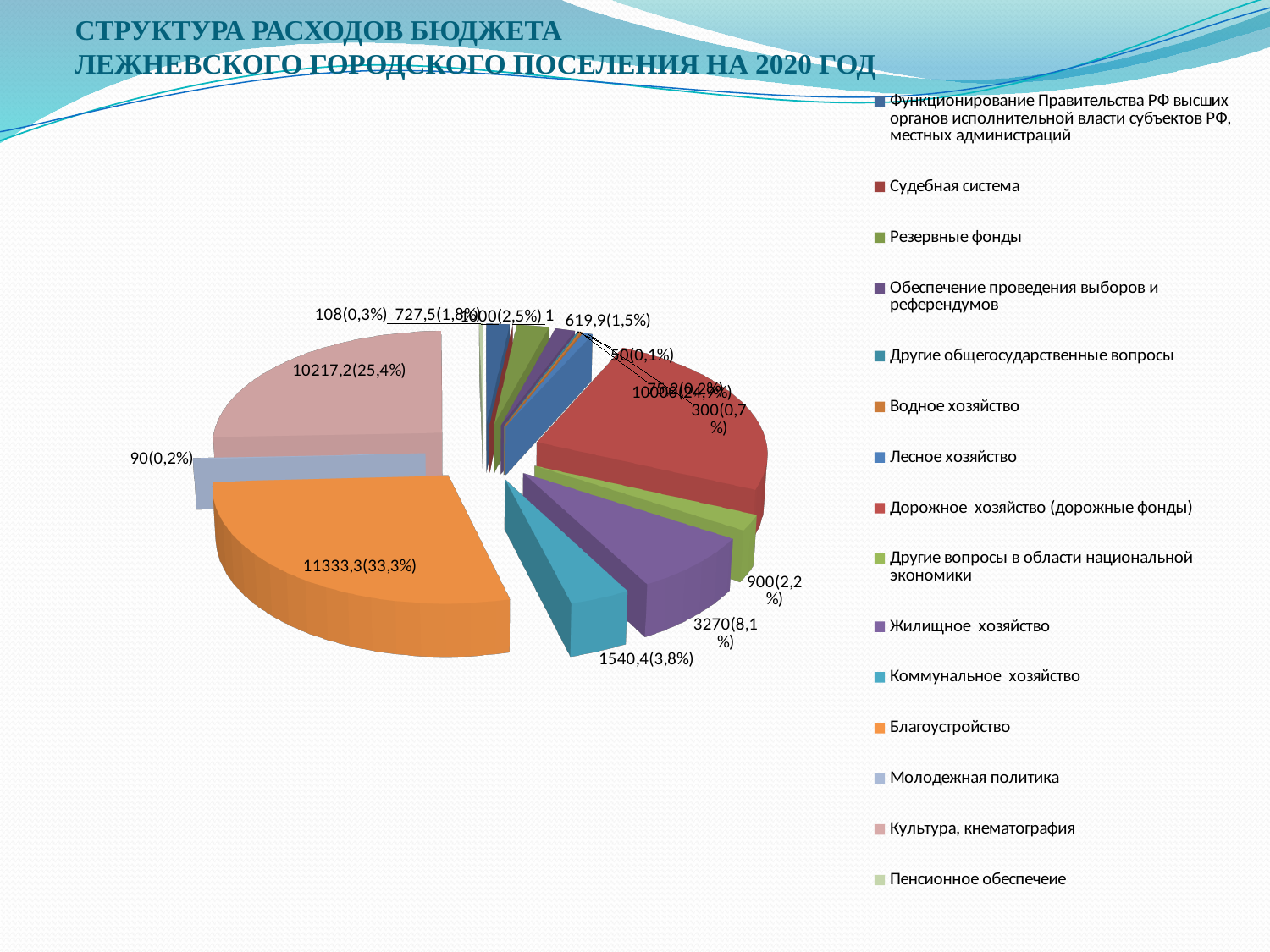
What value is labelled on the slice for Культура, кнематография? 10217,2(25,4%) What is the difference between the values for Благоустройство and Культура, кнематография? 1116,1 What value is labelled on the slice for Коммунальное хозяйство? 1540,4(3,8%) Which category has the largest slice of the pie? Благоустройство What colour is the slice for Благоустройство? orange Which has the larger share: Культура, кнематография or Дорожное хозяйство (дорожные фонды)? Культура, кнематография How many categories does the legend of the pie chart list? 15 What kind of chart is shown on the slide? pie chart What value is labelled on the slice for Жилищное хозяйство? 3270(8,1%) What share of the pie does Благоустройство take? 33,3% What value is labelled on the slice for Благоустройство? 11333,3(33,3%) What value is labelled on the slice for Дорожное хозяйство (дорожные фонды)? 10000(24,9%)